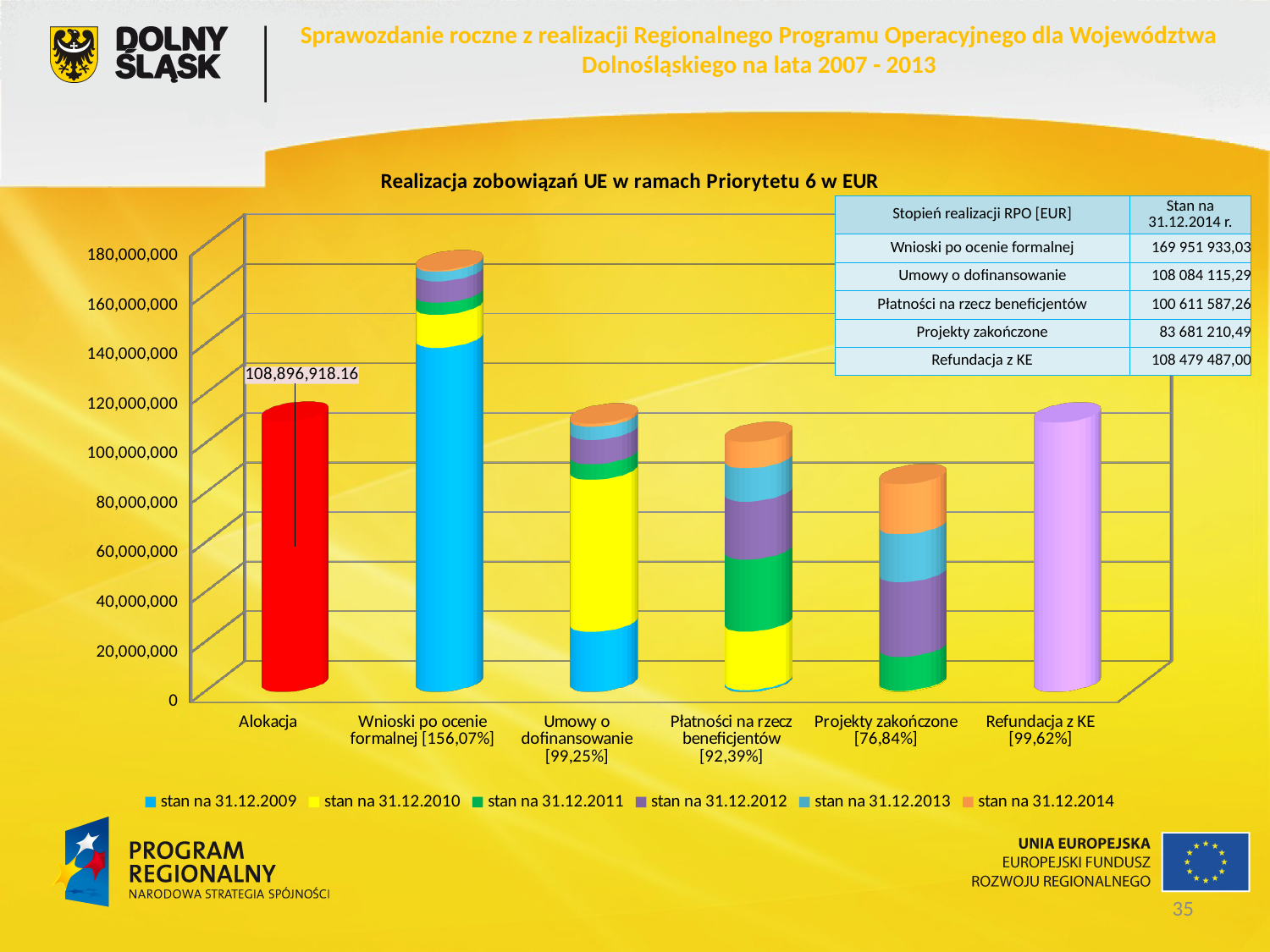
Is the total value for Projekty zakończone greater or less than 100,000,000? less How many categories are shown on the x axis of the chart? 6 How many series does the chart legend list? 6 What kind of chart is shown on the slide? Stacked bar chart What percentage is shown in the x-axis label for Płatności na rzecz beneficjentów? 92,39% Which category has the shortest bar in the chart? Projekty zakończone [76,84%] Which bar is taller: Umowy o dofinansowanie or Projekty zakończone? Umowy o dofinansowanie Which category has the tallest bar in the chart? Wnioski po ocenie formalnej [156,07%] What value is labelled on the Alokacja bar? 108,896,918.16 What is the title of the chart? Realizacja zobowiązań UE w ramach Priorytetu 6 w EUR Is the total value for Refundacja z KE greater or less than 120,000,000? less Is the total value for Wnioski po ocenie formalnej greater or less than 160,000,000? greater